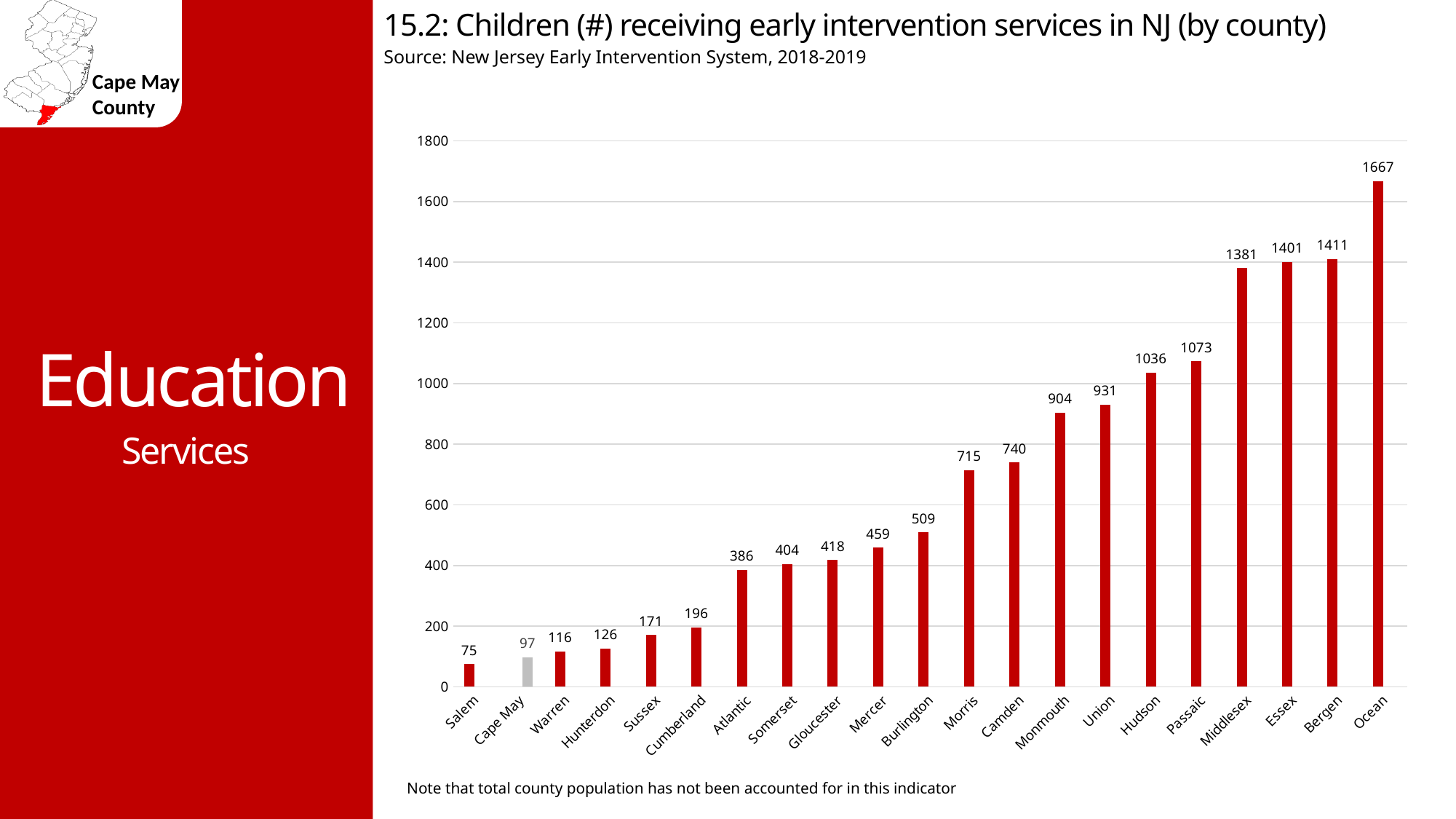
Which county has the highest number of children receiving early intervention services? Ocean Which county has the lowest number of children receiving early intervention services? Salem Which county has a larger value, Monmouth or Union? Union How many children received early intervention services in Cape May County? 97 Which county's bar is coloured grey instead of red? Cape May How many counties are shown on the x axis of the chart? 21 What is the difference between the values for Bergen and Essex? 10 What is the difference between the values for Cape May and Salem? 22 What is the value shown for Ocean County? 1667 Is the value for Passaic greater or less than 1000? greater What is the value shown for Hudson County? 1036 What type of chart is used on this slide? bar chart